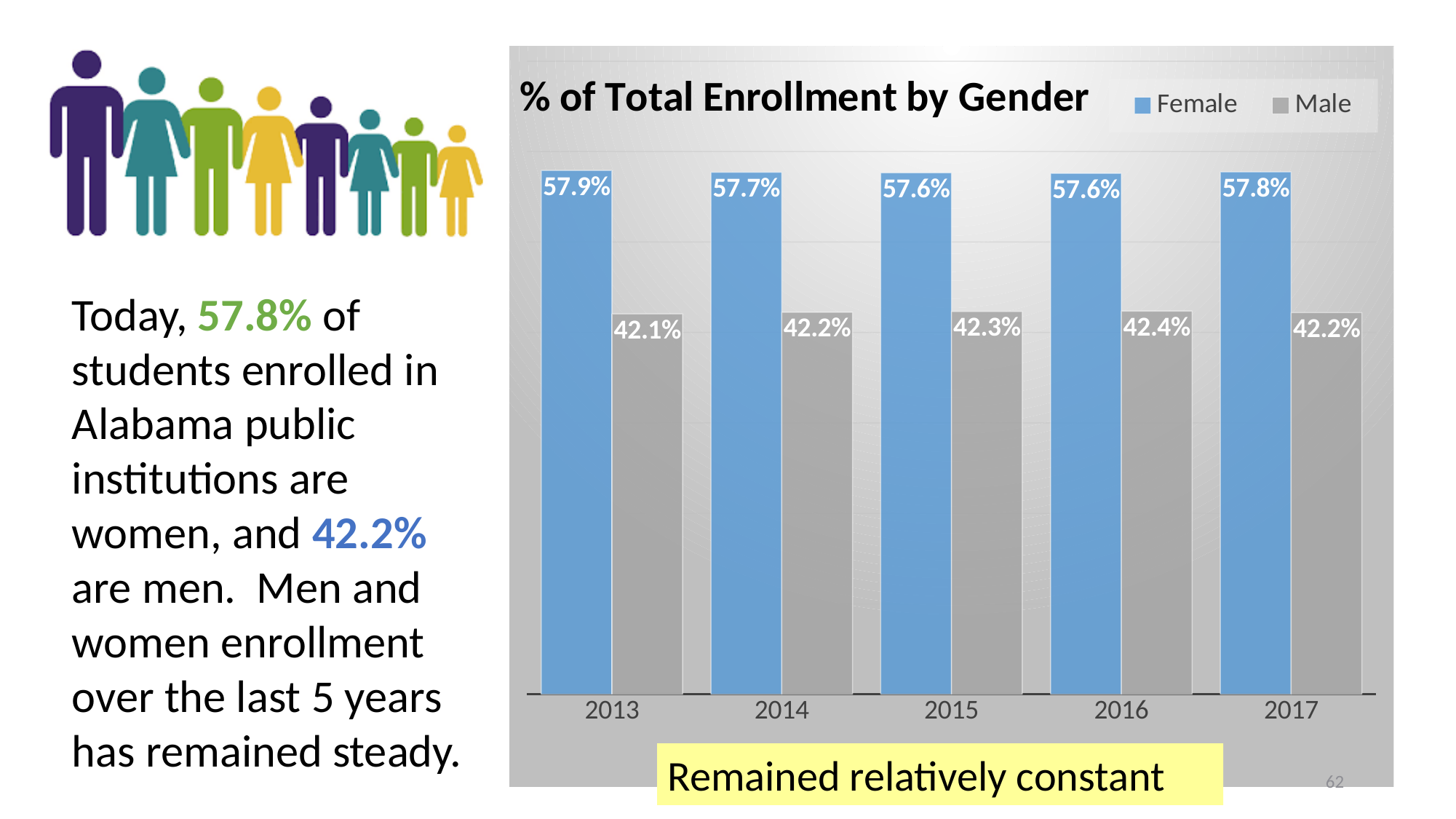
What is the Male value for 2016? 42.4% What is the title of the chart? % of Total Enrollment by Gender What kind of chart is shown? Bar chart Which is larger in 2017, the Female value or the Male value? Female What is the Female value for 2017? 57.8% What is the difference between the Female and Male values in 2015? 15.3% What is the Female value for 2013? 57.9% What is the Male value for 2014? 42.2% How many series does the legend list? 2 In which year is the Female value highest? 2013 In which year is the Male value lowest? 2013 How many years are shown on the x axis? 5